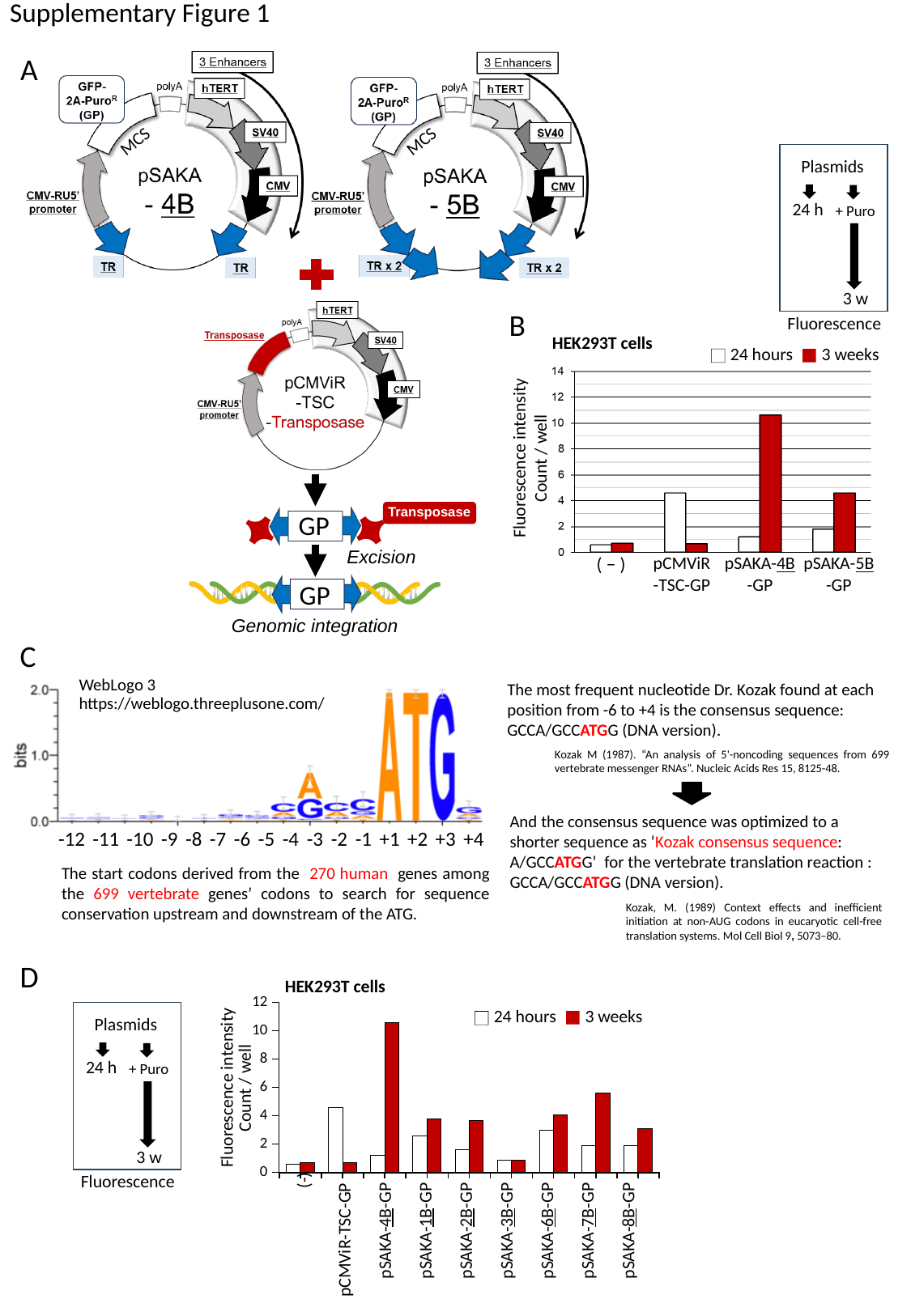
In the panel D chart, which category has the highest 3 weeks value? pSAKA-4B-GP What type of chart is shown in panel D? bar chart In the panel B chart, which is larger for pSAKA-5B-GP: the 24 hours value or the 3 weeks value? 3 weeks In the panel B chart, is the 3 weeks value for pSAKA-4B-GP greater or less than 10? greater In the panel B chart, how many series does the legend list? 2 In the panel D chart (HEK293T cells), how many categories are shown on the x axis? 9 In the panel B chart, is the 24 hours value for pCMViR-TSC-GP greater or less than 4? greater In the panel D chart, which is larger: the 3 weeks value for pSAKA-7B-GP or the 3 weeks value for pSAKA-8B-GP? pSAKA-7B-GP In the panel D chart, what colour represents the 3 weeks series? red In the panel D chart, is the 3 weeks value for pSAKA-7B-GP greater or less than 4? greater In the panel B chart, how many categories are shown on the x axis? 4 In the panel B chart (HEK293T cells), which category has the highest 3 weeks value? pSAKA-4B-GP